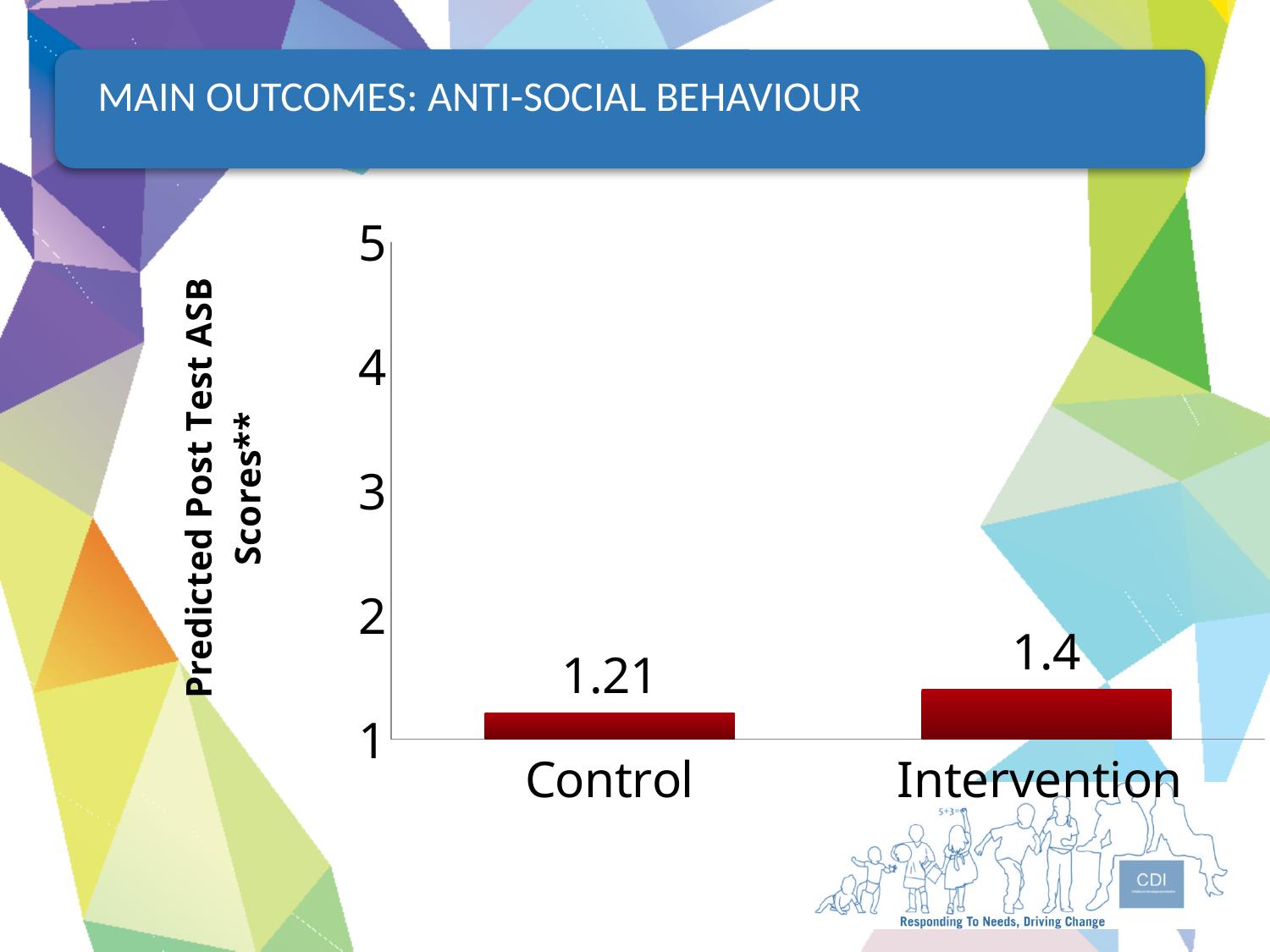
Is the value for Intervention greater or less than 2? less How many groups are shown on the x axis of the chart? 2 Which group has the lower predicted post test ASB score? Control Which group has the higher predicted post test ASB score? Intervention What is the predicted post test ASB score for the Intervention group? 1.4 What is the label of the y axis of the chart? Predicted Post Test ASB Scores** Is the value for Control larger or smaller than the value for Intervention? smaller What kind of chart is shown on the slide? bar chart What is the predicted post test ASB score for the Control group? 1.21 What is the highest value shown on the y axis of the chart? 5 What is the difference between the Intervention and Control predicted post test ASB scores? 0.19